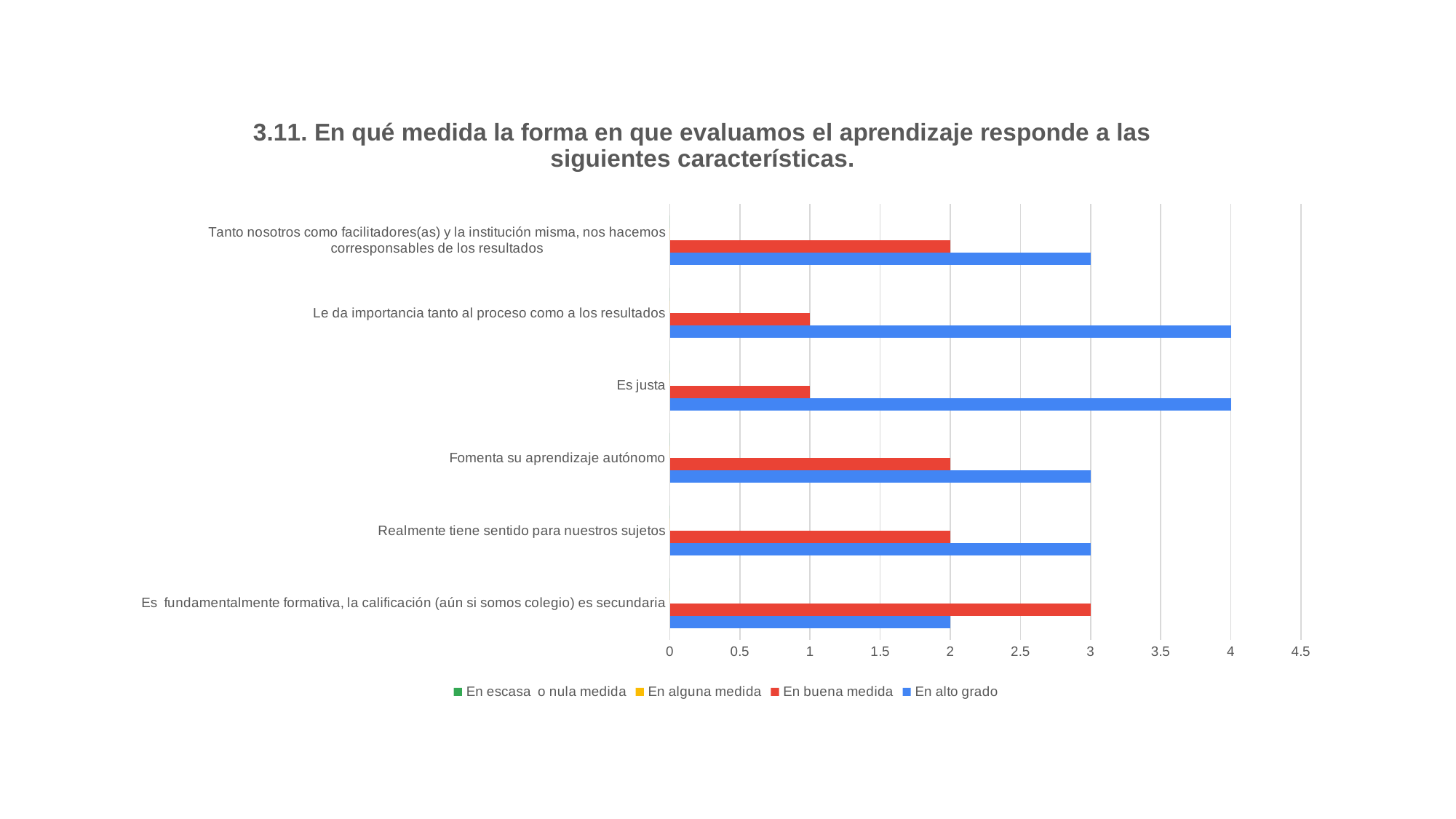
What is the value of 'En alto grado' for 'Es justa'? 4 What is the difference between 'En alto grado' and 'En buena medida' for 'Le da importancia tanto al proceso como a los resultados'? 3 Which category has the lowest value for 'En alto grado'? Es fundamentalmente formativa, la calificación (aún si somos colegio) es secundaria What type of chart is shown on the slide? bar chart How many series does the legend list? 4 How many categories are plotted on the chart? 6 What is the value of 'En buena medida' for 'Fomenta su aprendizaje autónomo'? 2 Which legend entry is shown in red? En buena medida What is the value of 'En alto grado' for 'Es fundamentalmente formativa, la calificación (aún si somos colegio) es secundaria'? 2 What is the value of 'En buena medida' for 'Le da importancia tanto al proceso como a los resultados'? 1 Which category has the highest value for 'En buena medida'? Es fundamentalmente formativa, la calificación (aún si somos colegio) es secundaria For 'Realmente tiene sentido para nuestros sujetos', which is larger: 'En alto grado' or 'En buena medida'? En alto grado